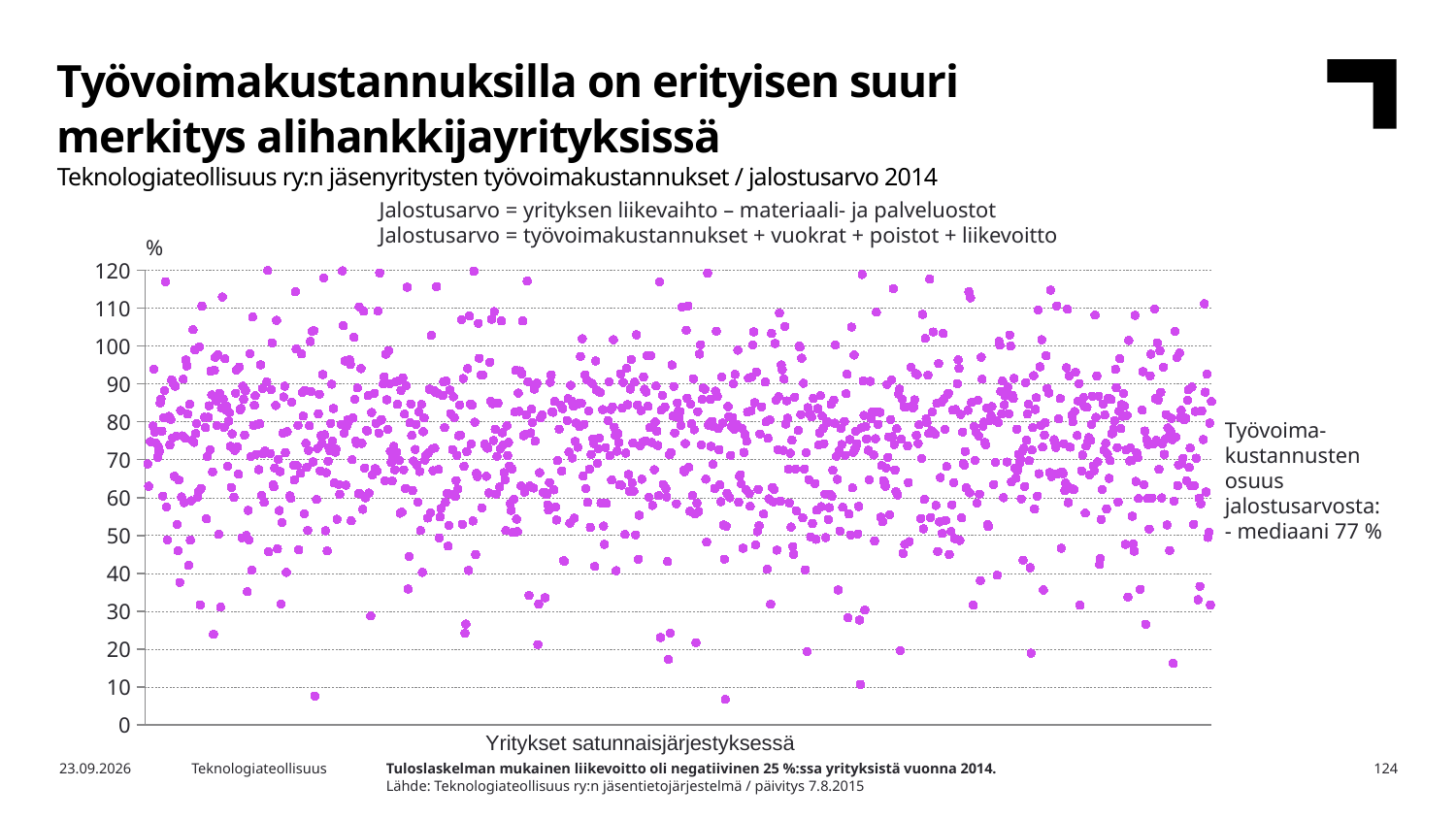
What kind of chart is shown on the slide? scatter chart What is the highest value shown on the vertical axis of the chart? 120 What is the label of the horizontal axis of the chart? Yritykset satunnaisjärjestyksessä According to the annotation on the chart, what is the median share of labour costs in value added? 77 %